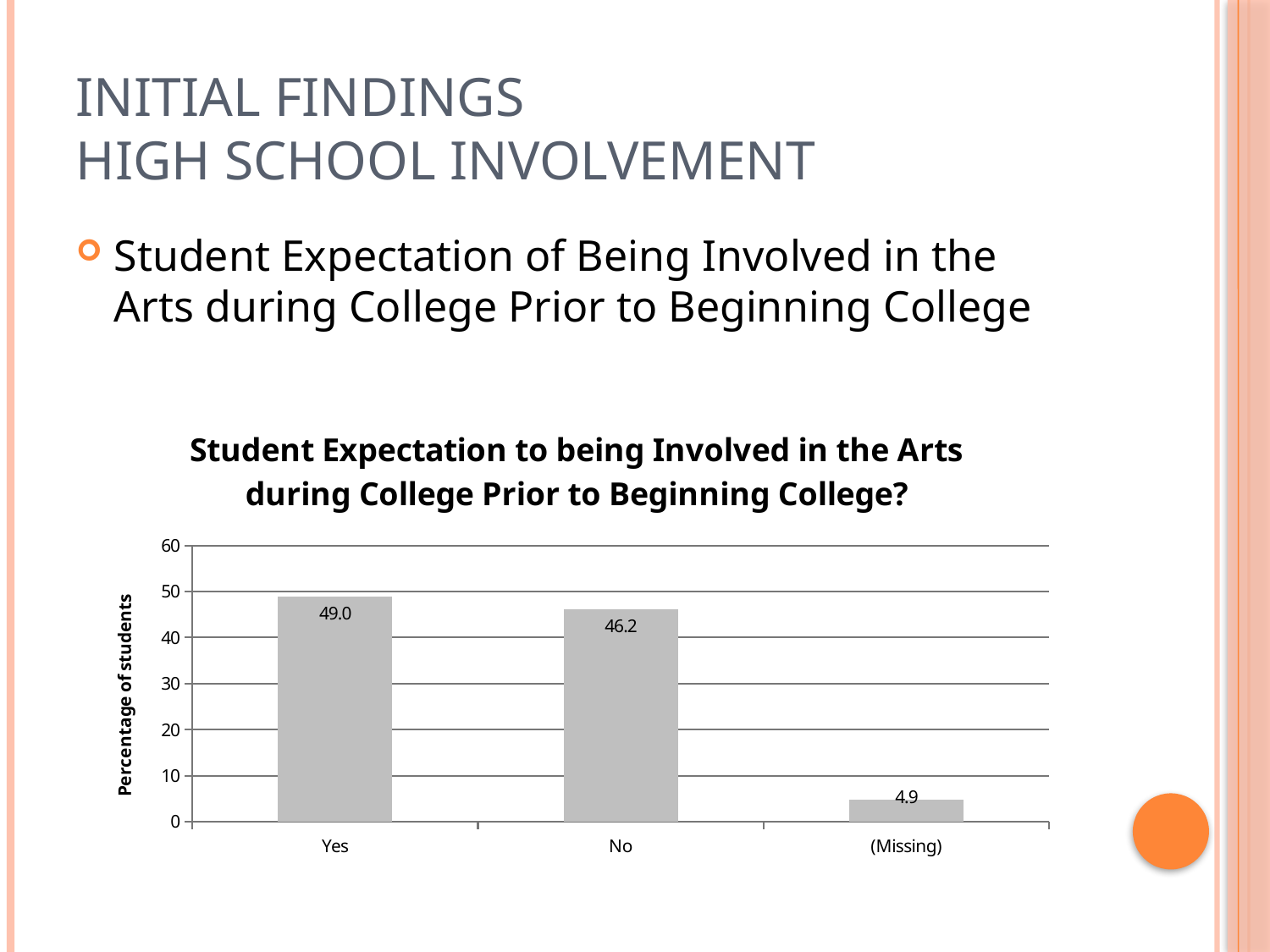
What is the value for No? 46.2 What is the label of the vertical axis? Percentage of students Which category has the lowest value? (Missing) How many categories are shown on the x axis? 3 Which category has the highest value? Yes Which is larger, the value for Yes or the value for No? Yes Is the value for No greater or less than 50? less What is the value for (Missing)? 4.9 What is the difference between the values for No and (Missing)? 41.3 What is the value for Yes? 49.0 What is the difference between the values for Yes and No? 2.8 What kind of chart is shown on the slide? bar chart